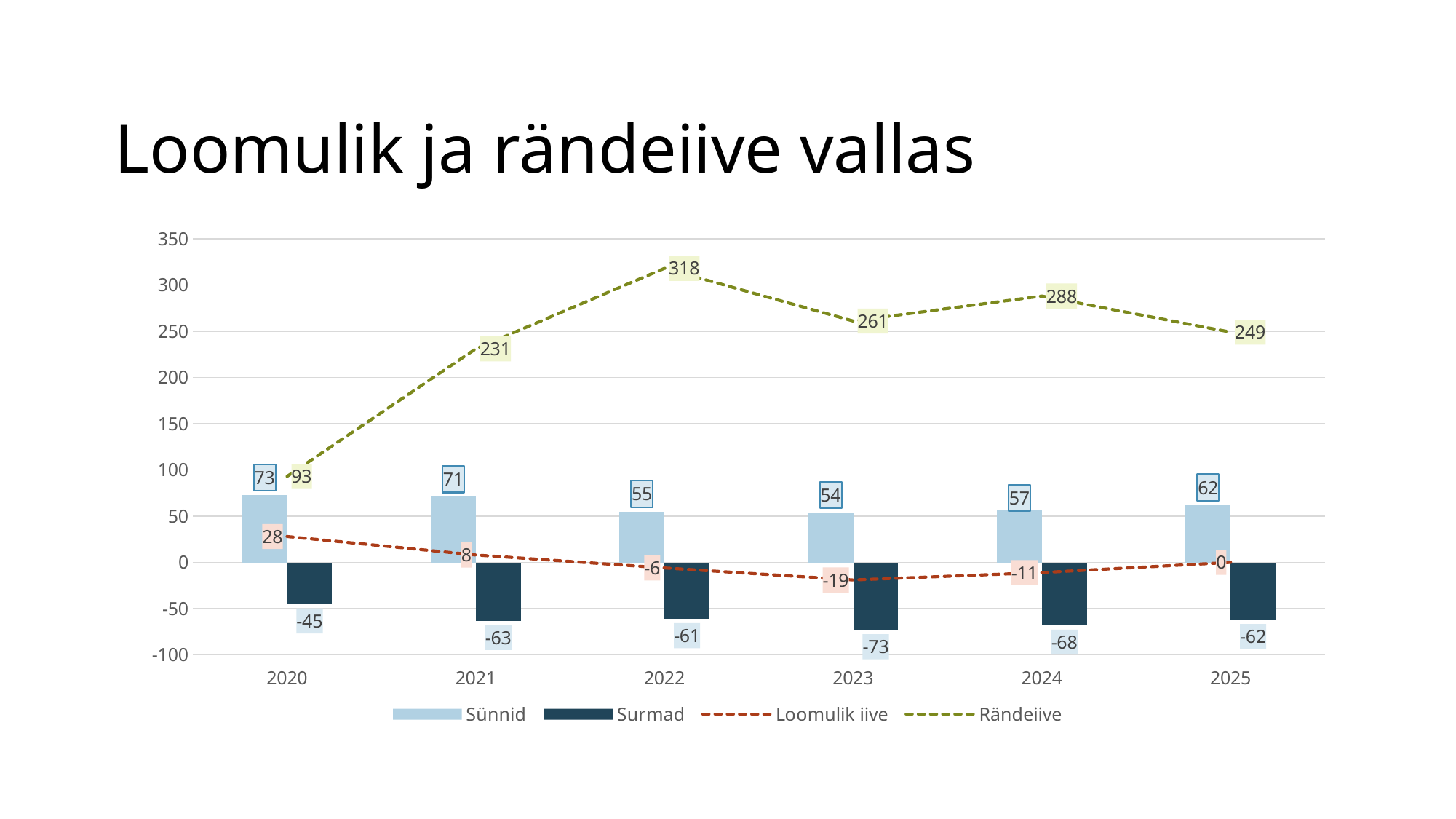
How many years are shown on the x axis? 6 In which year is Sünnid lowest? 2023 What is the value of Rändeiive in 2022? 318 What is the difference between Rändeiive in 2022 and in 2021? 87 What is the value of Sünnid in 2020? 73 In which year is Rändeiive highest? 2022 What is the title of the slide? Loomulik ja rändeiive vallas What kind of chart is this? Combined bar and line chart How many series does the legend list? 4 What is the value of Surmad in 2023? -73 Which is larger, Sünnid in 2021 or Sünnid in 2025? Sünnid in 2021 What is the value of Loomulik iive in 2025? 0